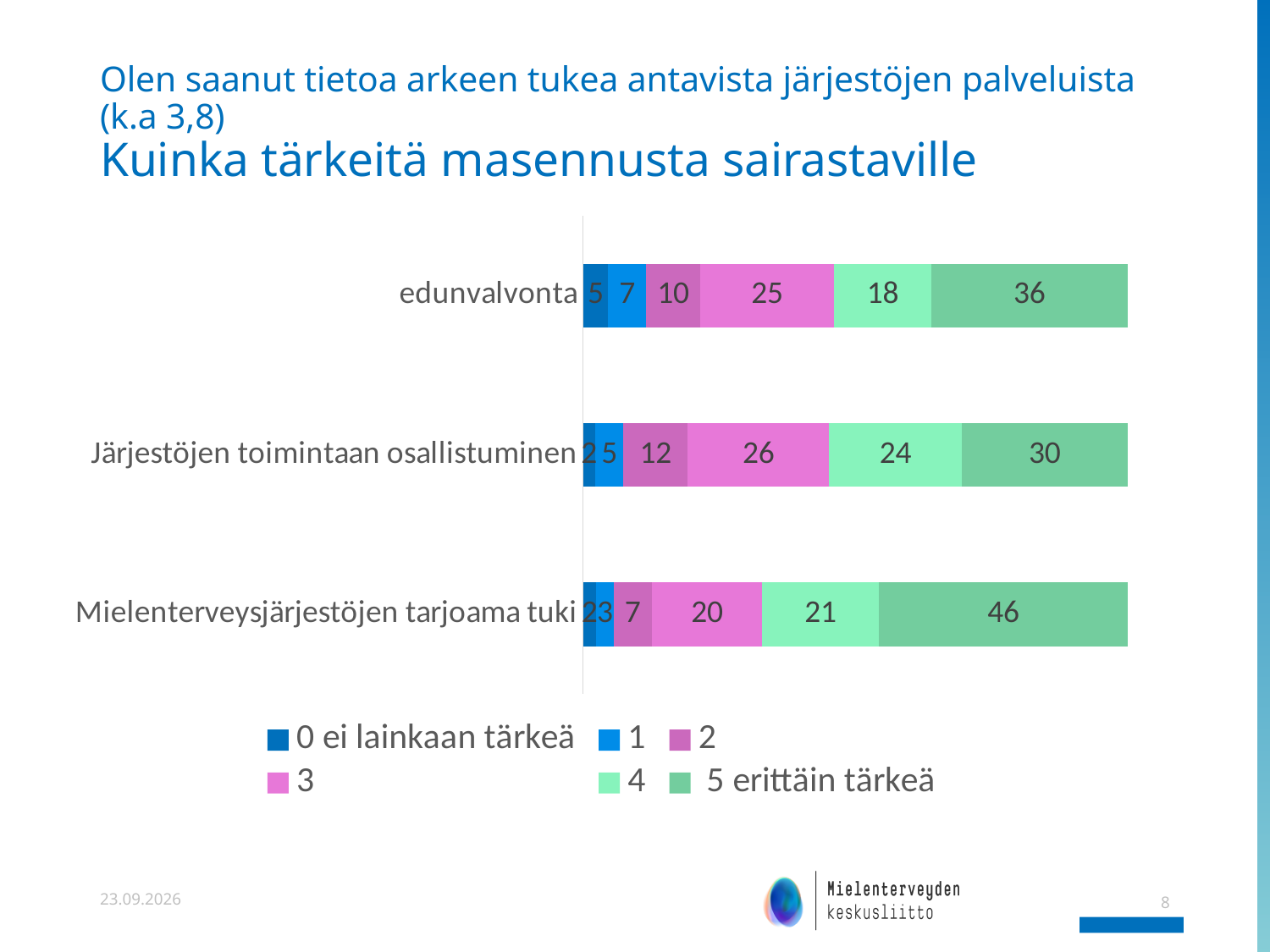
What is the difference between the '5 erittäin tärkeä' values for Mielenterveysjärjestöjen tarjoama tuki and edunvalvonta? 10 How many series does the legend list? 6 What is the value of '2' for edunvalvonta? 10 What kind of chart is shown on the slide? stacked bar chart Which is larger: the '3' value for edunvalvonta or the '3' value for Mielenterveysjärjestöjen tarjoama tuki? edunvalvonta How many categories are plotted in the chart? 3 Which category has the highest value for '5 erittäin tärkeä'? Mielenterveysjärjestöjen tarjoama tuki Which legend entry is shown in the darkest green colour? 5 erittäin tärkeä What is the value of '4' for edunvalvonta? 18 What is the value of '3' for Järjestöjen toimintaan osallistuminen? 26 Which category has the lowest value for '4'? edunvalvonta What is the value of '5 erittäin tärkeä' for Mielenterveysjärjestöjen tarjoama tuki? 46